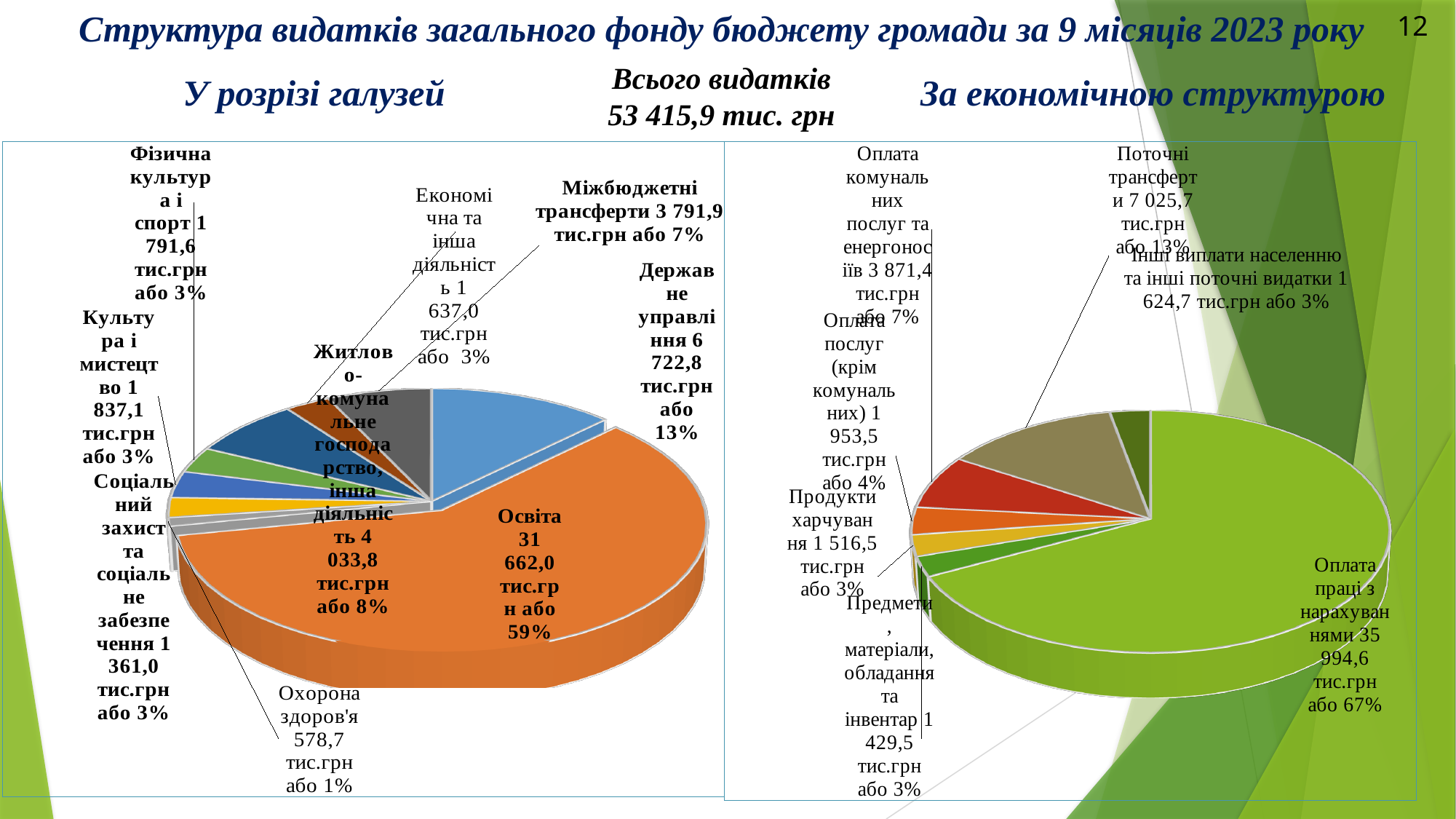
In the left chart (У розрізі галузей), what is the value for Освіта? 31 662,0 тис.грн або 59% In the left chart (У розрізі галузей), which category has the largest share? Освіта What total expenditure amount is stated on the slide (Всього видатків)? 53 415,9 тис. грн In the left chart (У розрізі галузей), what share does Державне управління have? 13% In the right chart (За економічною структурою), what is the value for Поточні трансферти? 7 025,7 тис.грн або 13% In the left chart (У розрізі галузей), which category has the smallest share? Охорона здоров'я In the right chart (За економічною структурою), how many categories are shown? 7 In the right chart (За економічною структурою), which is larger: Продукти харчування or Оплата послуг (крім комунальних)? Оплата послуг (крім комунальних) In the left chart (У розрізі галузей), which is larger: Міжбюджетні трансферти or Житлово-комунальне господарство, інша діяльність? Житлово-комунальне господарство, інша діяльність In the right chart (За економічною структурою), what is the value for Оплата праці з нарахуваннями? 35 994,6 тис.грн або 67% In the left chart (У розрізі галузей), how many categories are shown? 9 What kind of charts are shown on the slide? Pie charts